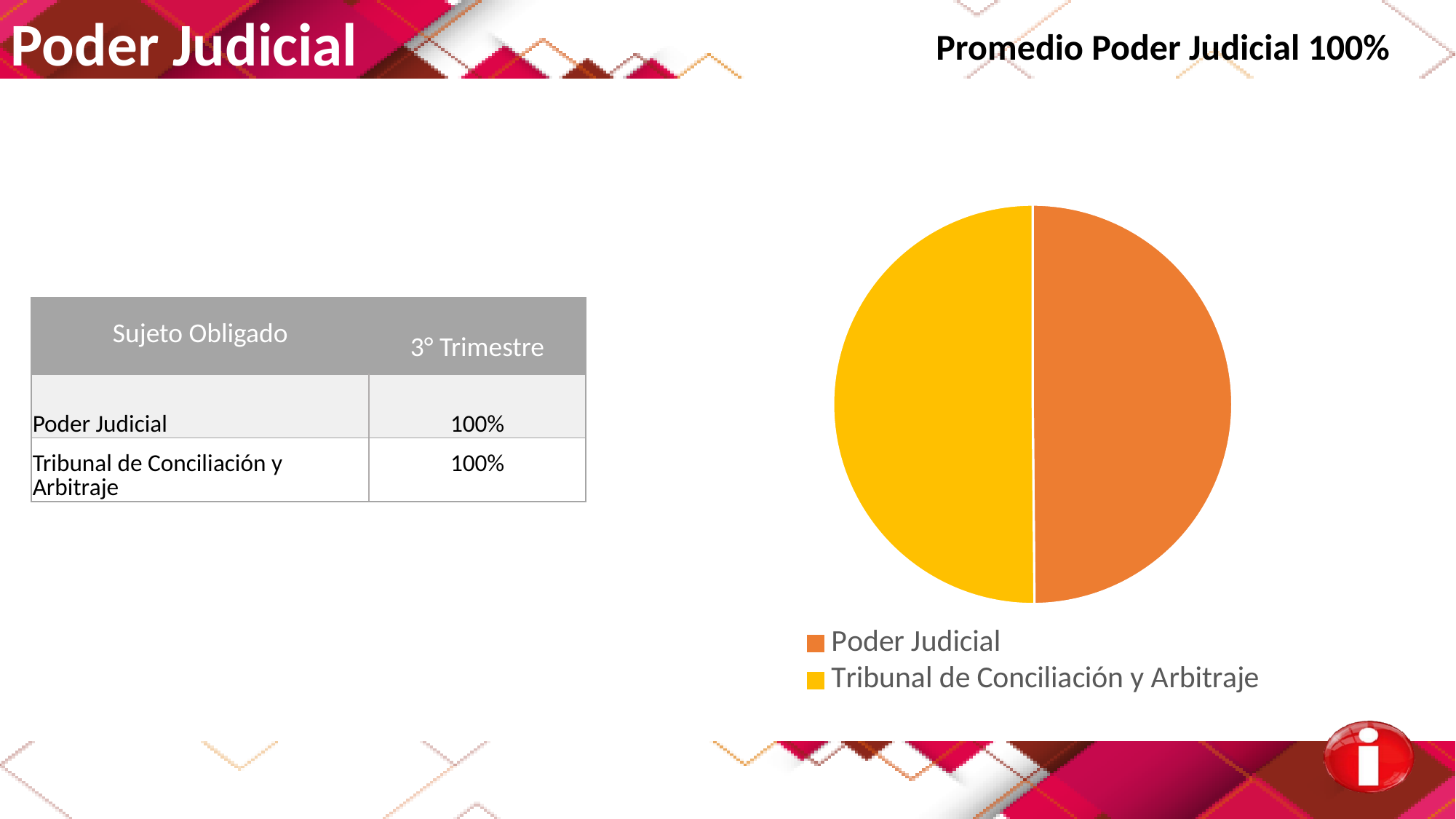
How many entries does the legend of the pie chart list? 2 How many slices does the pie chart have? 2 According to the table, what is the 3° Trimestre value for Tribunal de Conciliación y Arbitraje? 100% According to the table, what is the 3° Trimestre value for Poder Judicial? 100% Which colour represents Tribunal de Conciliación y Arbitraje in the pie chart? Yellow Which colour represents Poder Judicial in the pie chart? Orange What is the difference between the 3° Trimestre values of Poder Judicial and Tribunal de Conciliación y Arbitraje in the table? 0% What kind of chart is shown on the slide? Pie chart